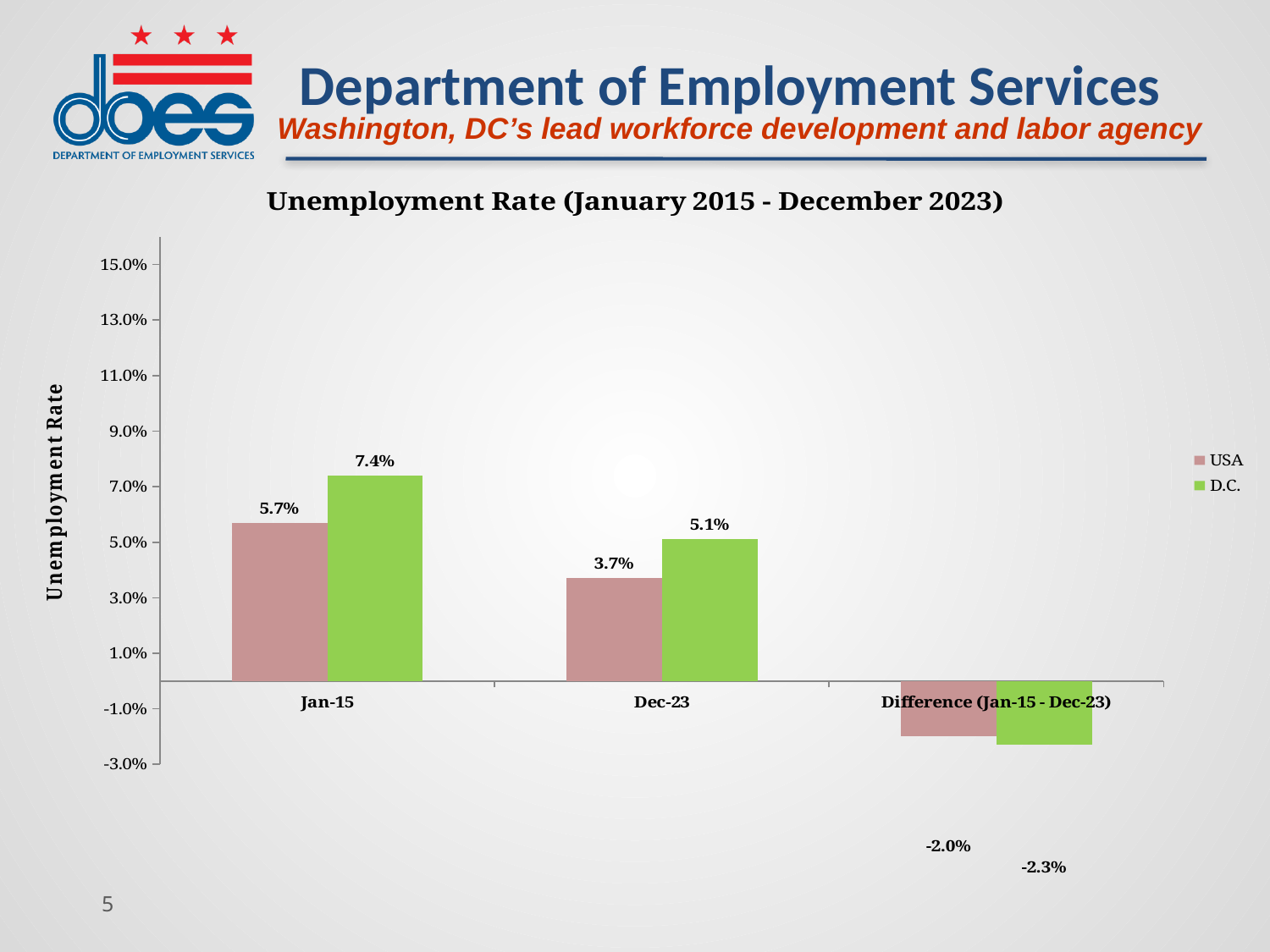
How many categories are shown on the x axis? 3 What is the USA value for Difference (Jan-15 - Dec-23)? -2.0% What is the D.C. unemployment rate for Dec-23? 5.1% What is the USA unemployment rate for Jan-15? 5.7% How many series does the legend list? 2 For Dec-23, which is larger, the USA rate or the D.C. rate? D.C. Which category has the lowest USA value? Difference (Jan-15 - Dec-23) What type of chart is shown? Bar chart What is the D.C. value for Difference (Jan-15 - Dec-23)? -2.3% What is the difference between the D.C. and USA unemployment rates for Jan-15? 1.7% Is the D.C. value for Jan-15 greater or less than 7.0%? greater Which category has the highest D.C. unemployment rate? Jan-15